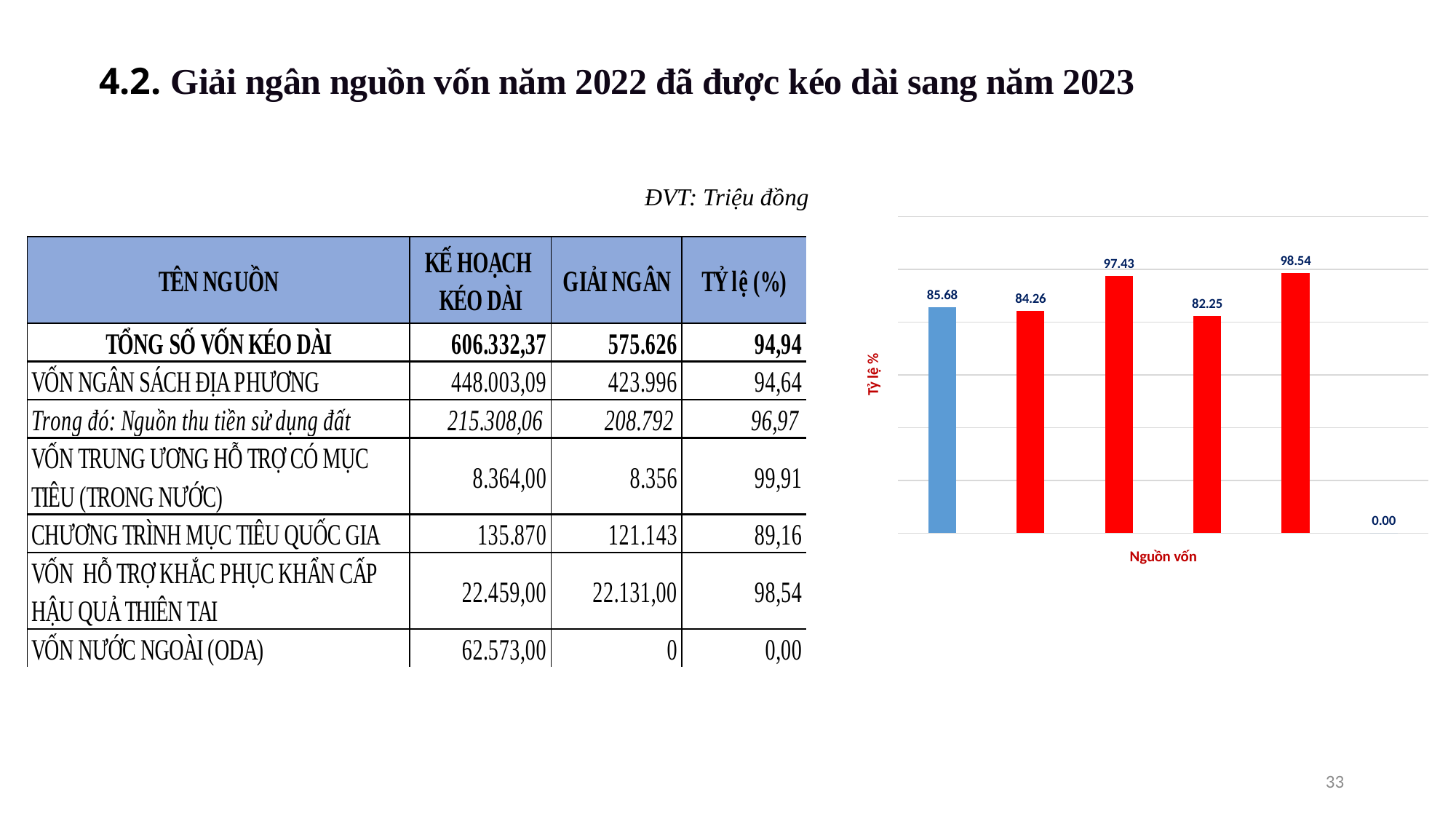
In the bar chart, which is larger: the third bar or the fifth bar? the fifth bar (98.54) What is the title of the vertical axis of the bar chart? Tỷ lệ % In the bar chart, what is the difference between the first bar (85.68) and the fourth bar (82.25)? 3.43 In the bar chart, what is the lowest labelled value? 0.00 In the bar chart, what is the highest labelled value? 98.54 In the bar chart, what value is labelled on the third bar? 97.43 In the bar chart, what is the difference between the fifth bar (98.54) and the third bar (97.43)? 1.11 How many data labels are shown in the bar chart? 6 What type of chart is shown on the right of the slide? bar chart In the bar chart, what value is labelled on the second bar? 84.26 In the bar chart, what value is labelled on the fourth bar? 82.25 In the bar chart, what value is labelled on the first (blue) bar? 85.68